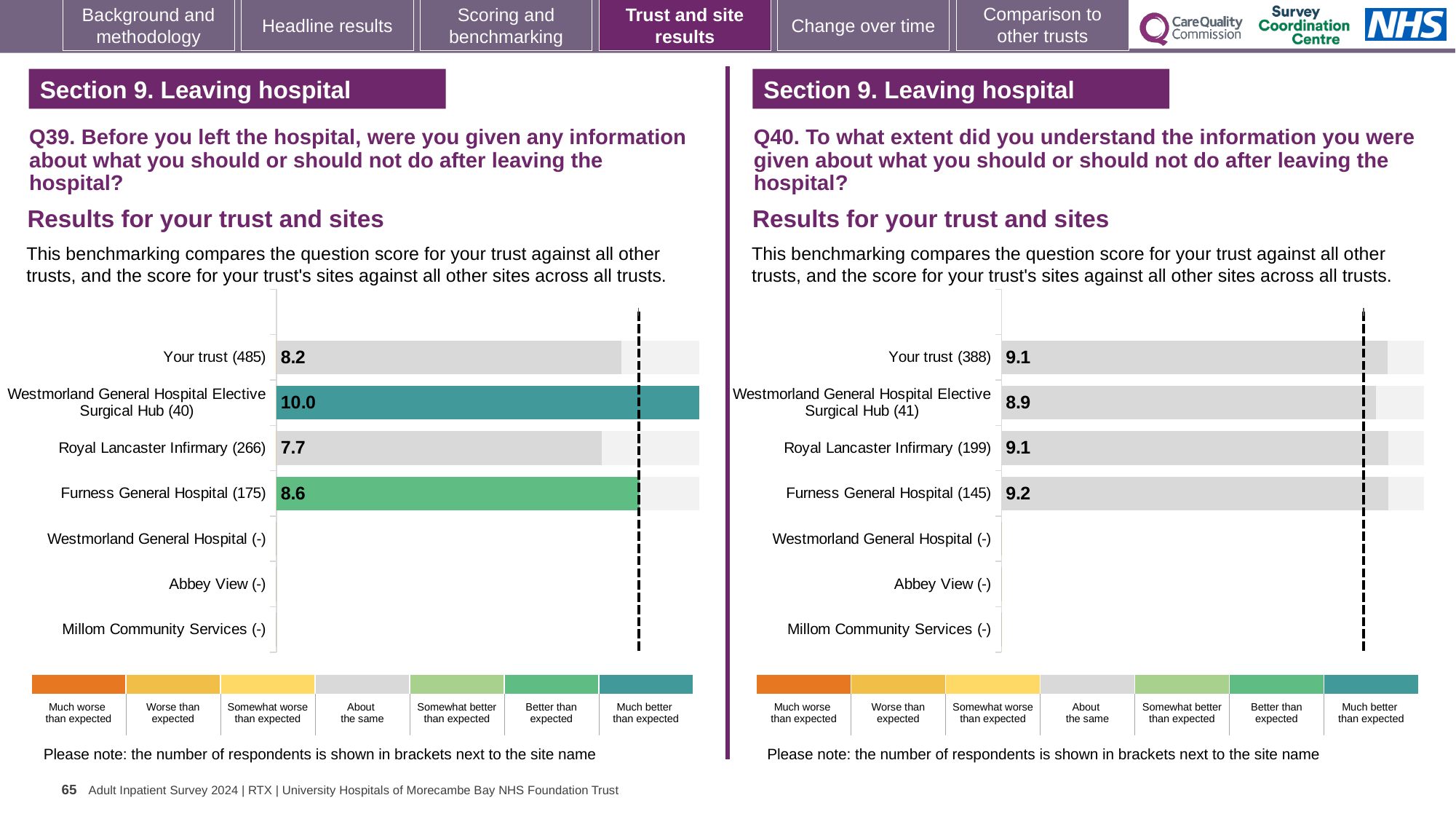
In the Q39 chart on the left, which site with a plotted score has the lowest score? Royal Lancaster Infirmary In the Q39 chart on the left, which benchmark category does the colour of the Westmorland General Hospital Elective Surgical Hub bar correspond to? Much better than expected In the Q39 chart on the left, what is the score for Royal Lancaster Infirmary? 7.7 In the Q40 chart on the right, what is the score for Furness General Hospital? 9.2 In the Q39 chart on the left, what is the difference between the scores for Westmorland General Hospital Elective Surgical Hub and Royal Lancaster Infirmary? 2.3 In the Q39 chart on the left, what is the score for Your trust? 8.2 In the Q39 chart on the left, which site has the highest score? Westmorland General Hospital Elective Surgical Hub How many site/trust categories are listed on the y axis of the Q40 chart on the right? 7 What kind of chart is used for the Q39 results on the left? Bar chart In the Q40 chart on the right, what is the difference between the scores for Furness General Hospital and Westmorland General Hospital Elective Surgical Hub? 0.3 In the Q39 chart on the left, which has the higher score: Furness General Hospital or Your trust? Furness General Hospital In the Q40 chart on the right, what is the score for Westmorland General Hospital Elective Surgical Hub? 8.9